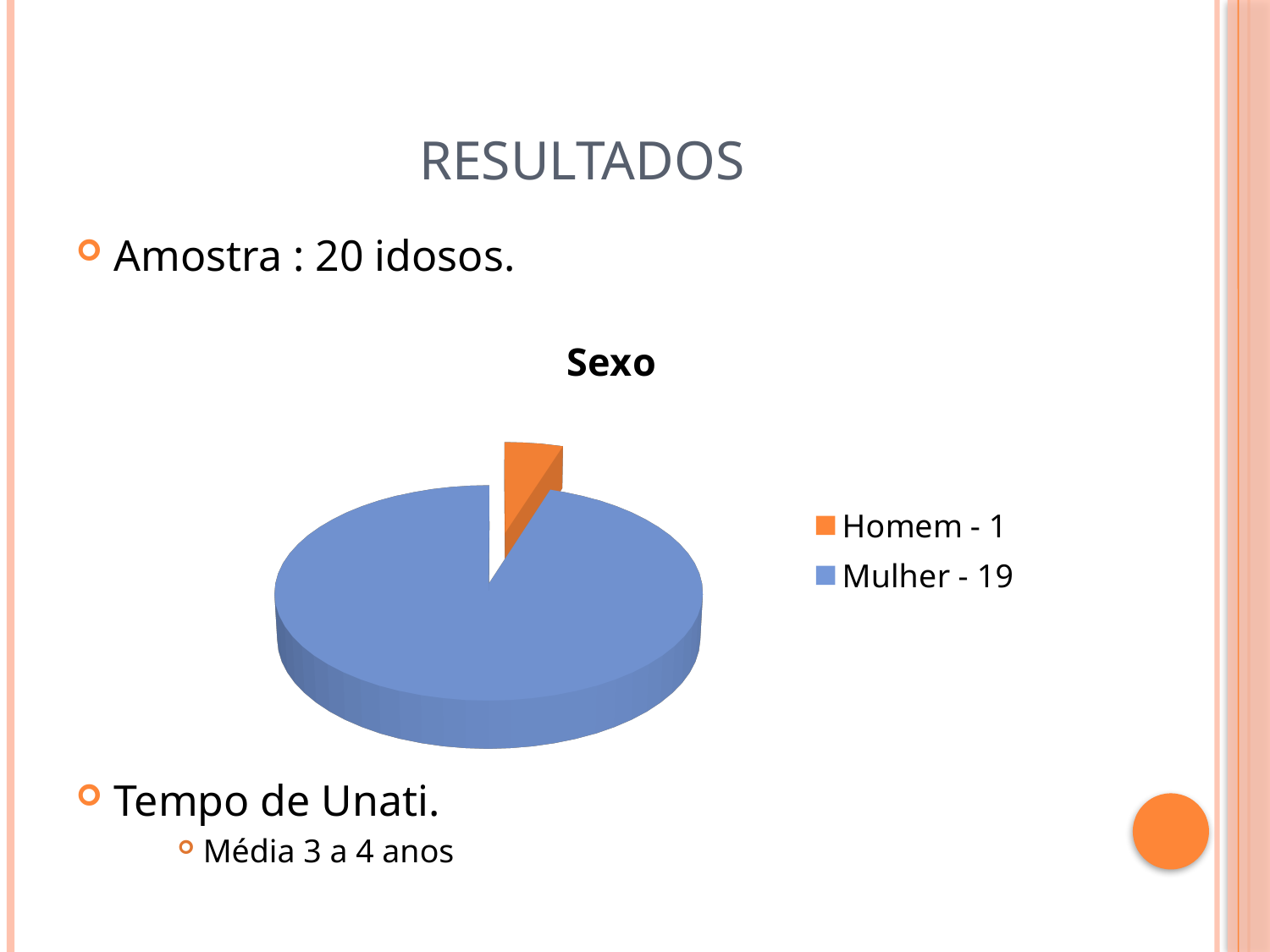
Which category has the largest slice of the pie? Mulher Which colour represents Homem in the pie chart? orange What share of the pie does Mulher represent? 95% What is the value for Mulher in the pie chart? 19 How many entries does the legend list? 2 What is the value for Homem in the pie chart? 1 What type of chart is shown on the slide? pie chart Which is larger, the value for Homem or the value for Mulher? Mulher How many slices does the pie chart have? 2 What is the difference between the values for Mulher and Homem? 18 Which category has the smallest slice of the pie? Homem What is the title of the chart? Sexo